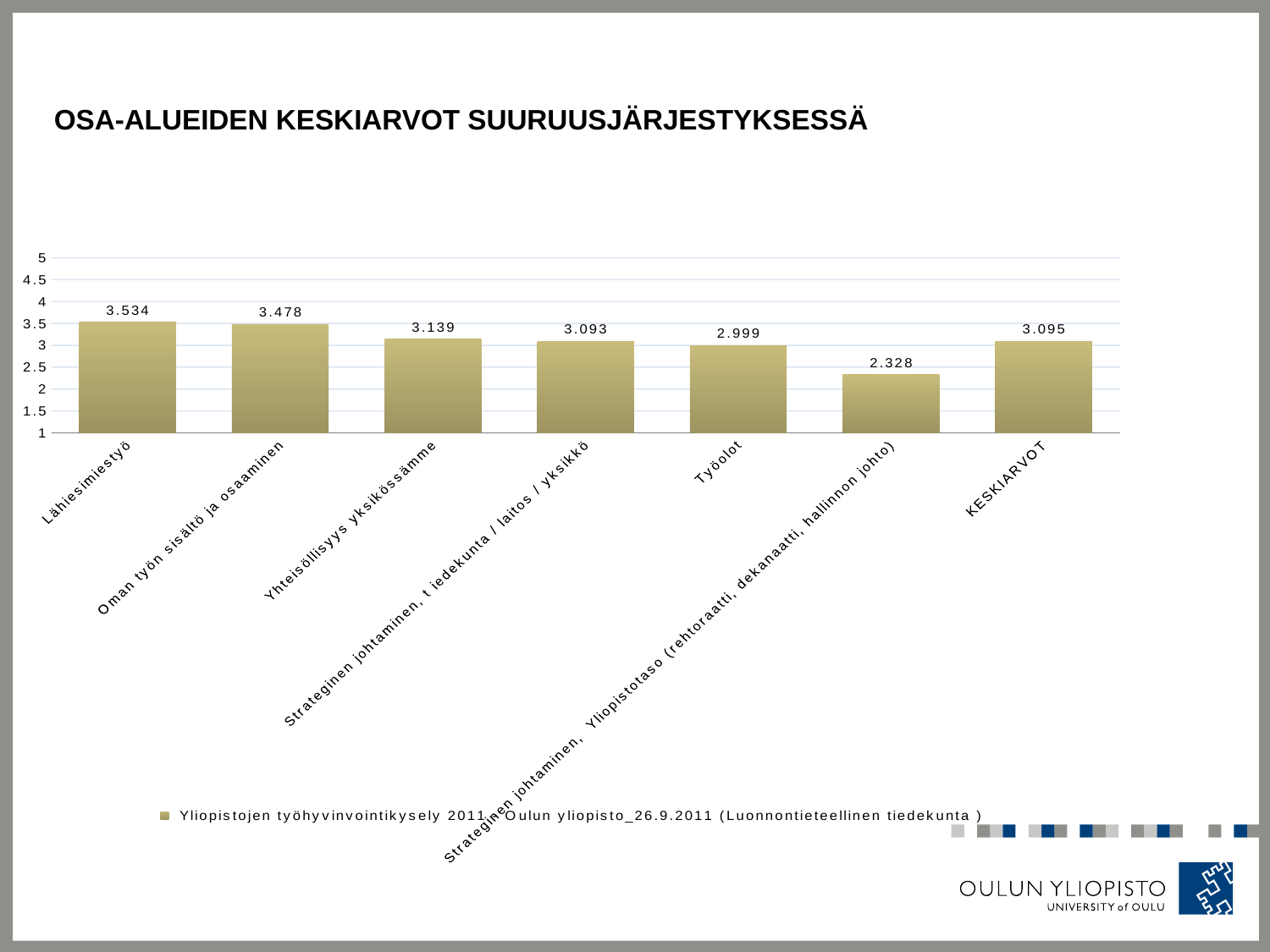
What is the value for KESKIARVOT? 3.095 Which category has the lowest value? Strateginen johtaminen, Yliopistotaso (rehtoraatti, dekanaatti, hallinnon johto) What kind of chart is shown on the slide? Bar chart Which category has the highest value? Lähiesimiestyö What is the value for Lähiesimiestyö? 3.534 What is the value for Työolot? 2.999 How many series does the legend list? 1 How many categories are shown on the x axis? 7 What is the value for Yhteisöllisyys yksikössämme? 3.139 What is the difference between the values for KESKIARVOT and Työolot? 0.096 What is the difference between the values for Lähiesimiestyö and Strateginen johtaminen, Yliopistotaso (rehtoraatti, dekanaatti, hallinnon johto)? 1.206 Which is larger, the value for Oman työn sisältö ja osaaminen or the value for Yhteisöllisyys yksikössämme? Oman työn sisältö ja osaaminen